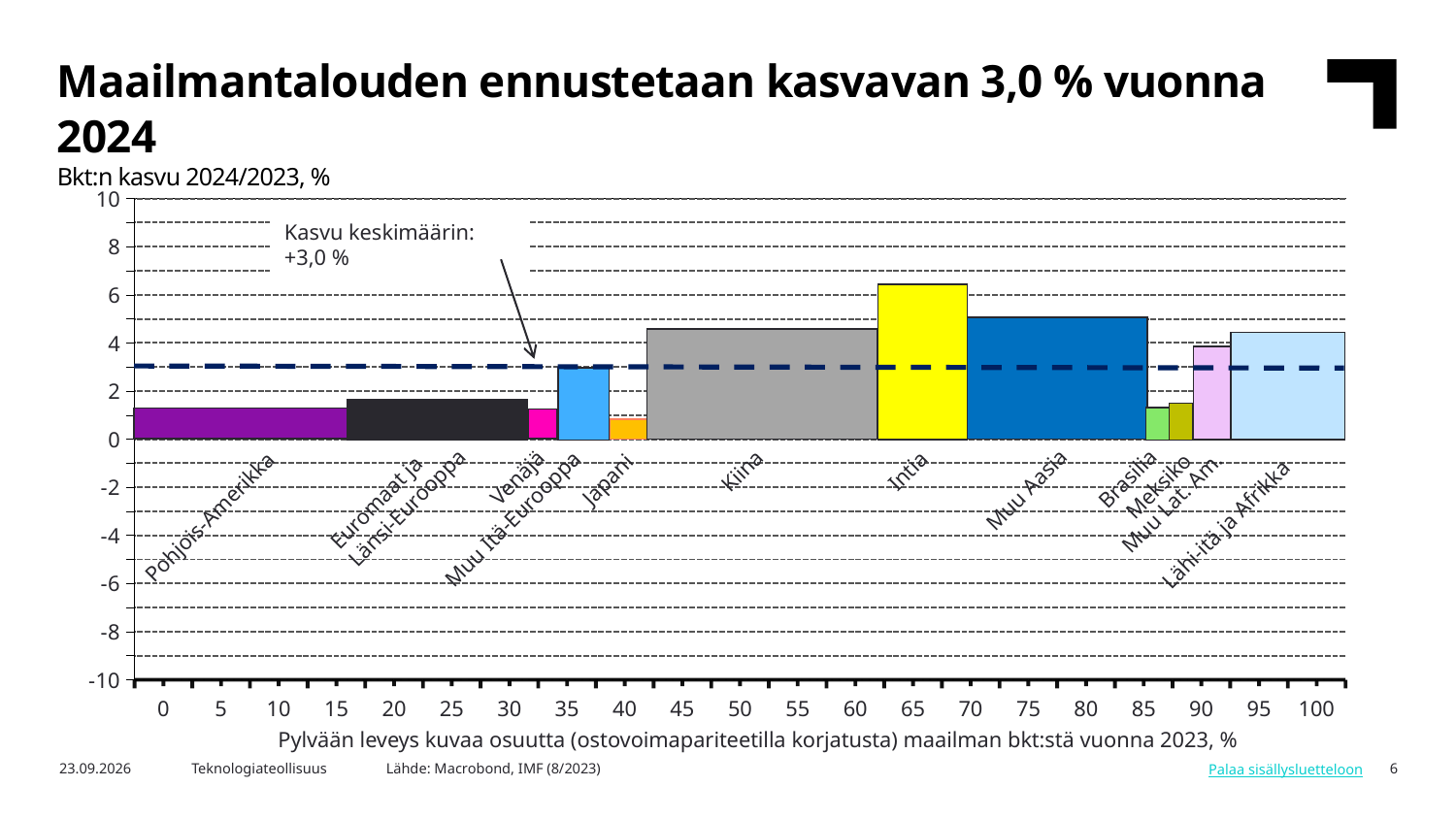
Which has the higher GDP growth, Kiina or Euromaat ja Länsi-Eurooppa? Kiina Which has the higher GDP growth, Intia or Kiina? Intia Which region has the highest GDP growth in the chart? Intia What average growth value is annotated on the chart (Kasvu keskimäärin)? +3,0 % According to the note below the x axis, what does the width of each bar represent? Share of world GDP (PPP-adjusted) in 2023, % Is the value for Pohjois-Amerikka greater or less than 2? less What kind of chart is shown on the slide? bar chart Is the value for Intia greater or less than 6? greater How many regions (bars) are shown in the chart? 12 Is the value for Japani greater or less than 2? less